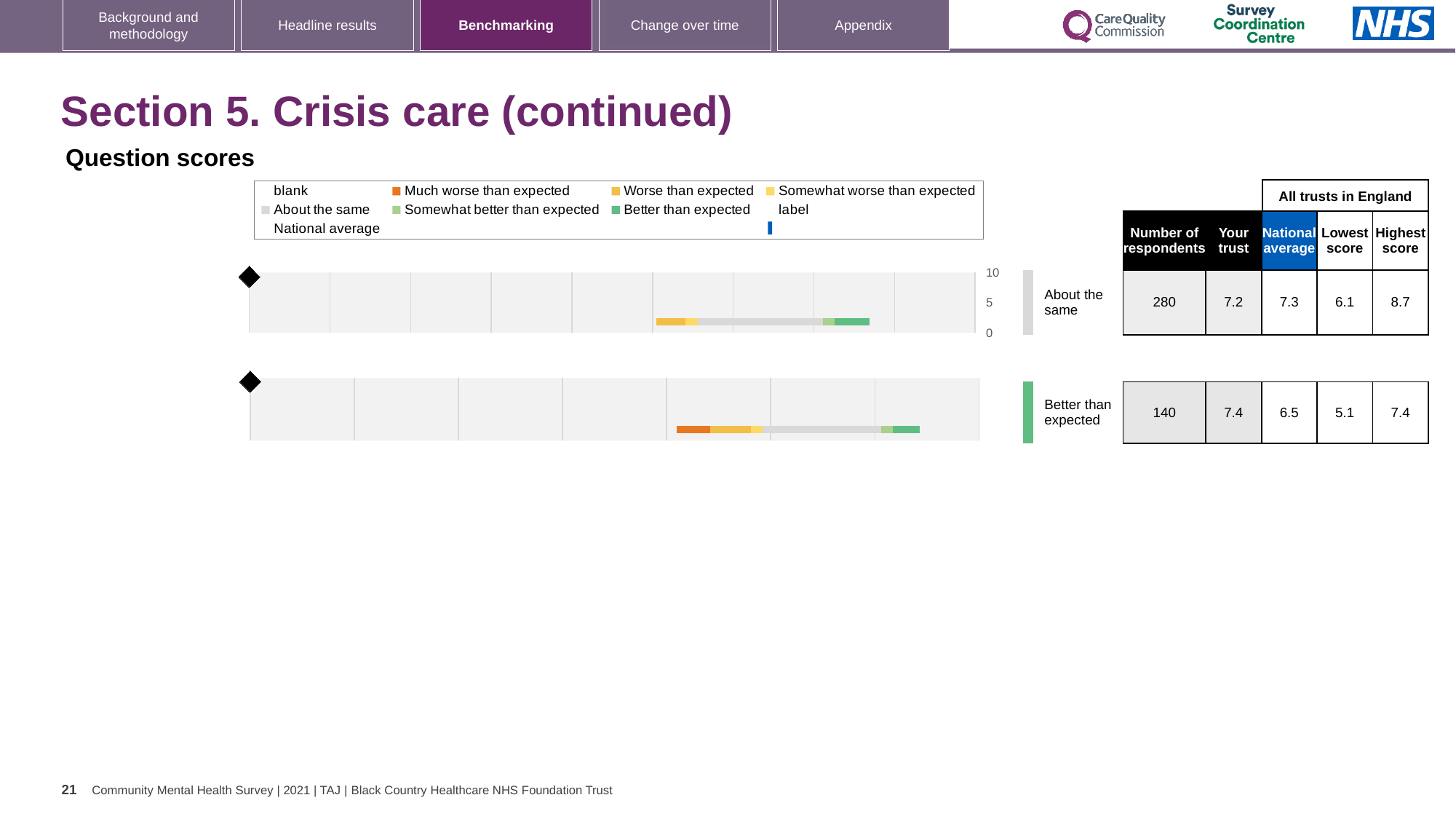
Is the 'Your trust' score for the 'About the same' row greater or less than 5 on the chart axis? greater What is the heading above the charts on this slide? Question scores For the 'Better than expected' row, how much higher is the 'Your trust' score than the national average? 0.9 For the 'About the same' row, what is the difference between the highest score and the lowest score across all trusts in England? 2.6 For the 'Better than expected' row, how many respondents are there? 140 Which row has the larger 'Your trust' score, 'About the same' or 'Better than expected'? Better than expected For the 'About the same' row, what is the national average score? 7.3 For the first chart row, rated 'About the same', what is the 'Your trust' score? 7.2 Which row has more respondents, 'About the same' or 'Better than expected'? About the same What kind of chart is used to show the question scores on this slide? bar chart For the second chart row, rated 'Better than expected', what is the 'Your trust' score? 7.4 How many question score rows (charts) are shown on the slide? 2